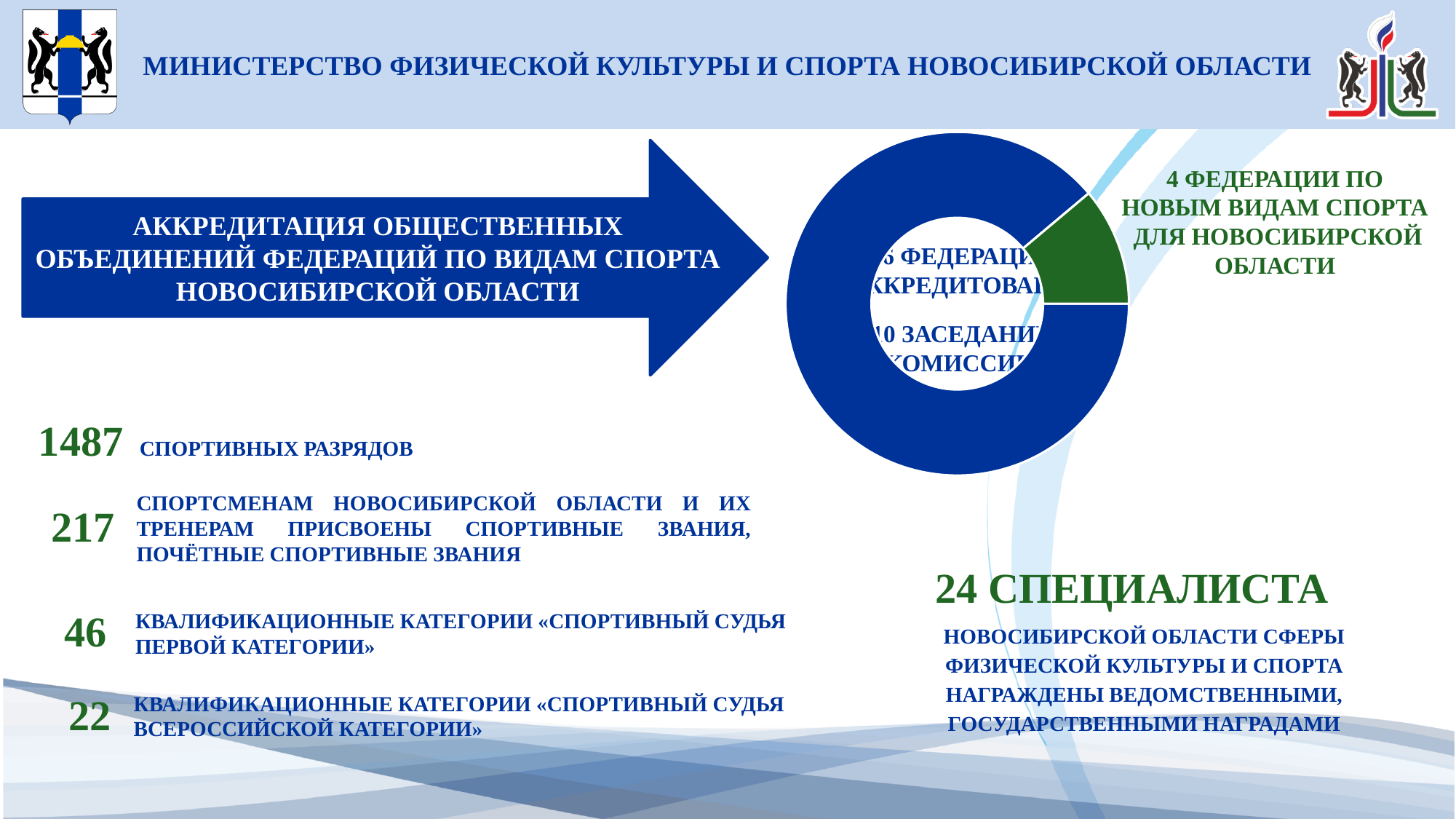
What colour is the slice labelled "4 ФЕДЕРАЦИИ ПО НОВЫМ ВИДАМ СПОРТА ДЛЯ НОВОСИБИРСКОЙ ОБЛАСТИ"? Green What kind of chart is shown on the slide? Pie chart (donut) How many slices does the donut chart have? 2 Which slice of the donut chart is the smallest? The green slice (4 федерации по новым видам спорта) Which slice of the donut chart is larger, the blue one or the green one? The blue one What colour is the largest slice of the donut chart? Blue How many federations for new kinds of sport does the green slice of the donut chart represent? 4